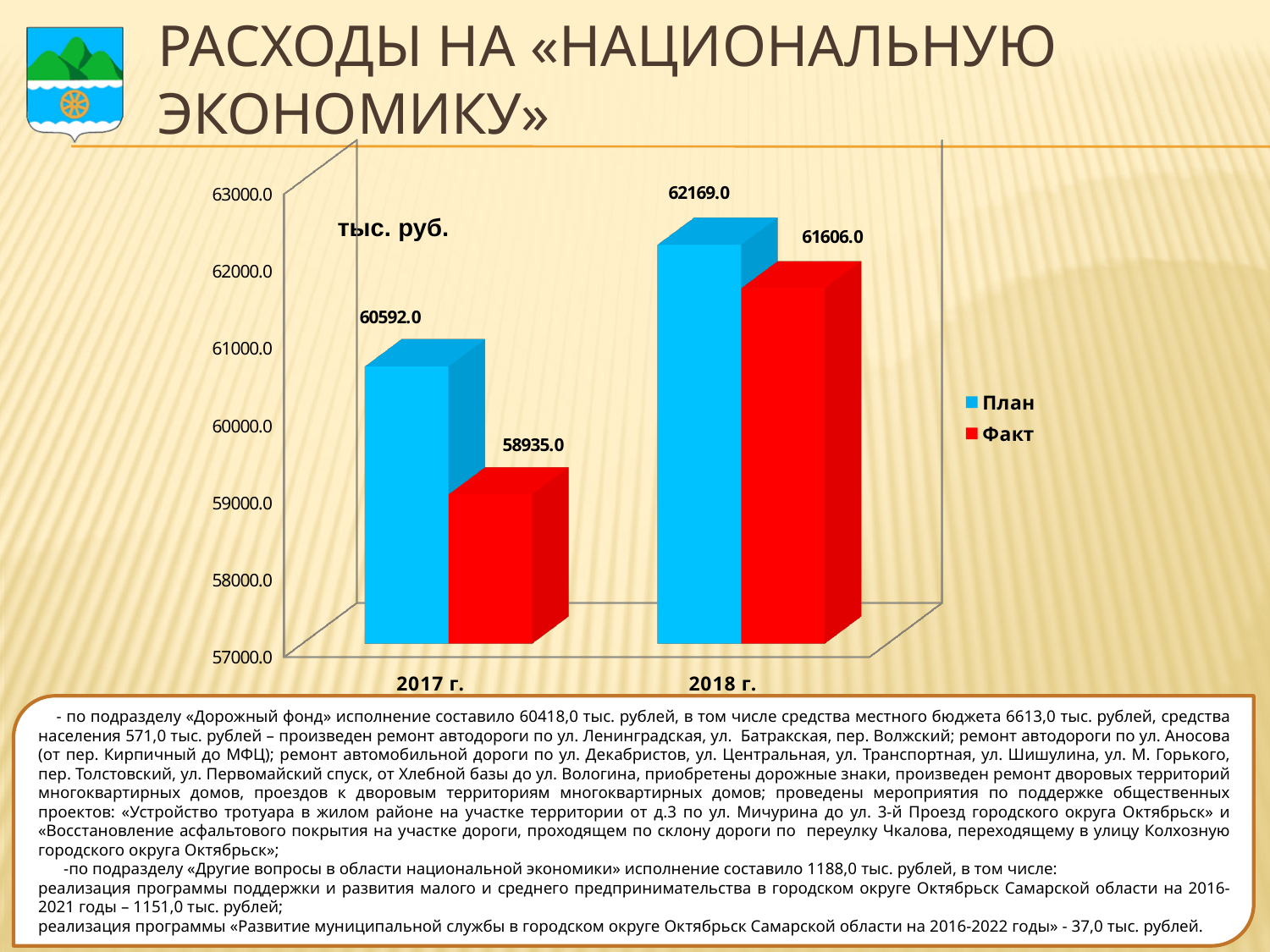
What is the Факт value for 2018 г.? 61606.0 What is the difference between План and Факт for 2017 г.? 1657.0 Which is larger for 2018 г., План or Факт? План What is the План value for 2017 г.? 60592.0 What unit label is shown inside the chart area? тыс. руб. What is the difference between План and Факт for 2018 г.? 563.0 What kind of chart is shown on the slide? Bar chart How many series does the legend list? 2 Which bar on the chart has the lowest value? Факт for 2017 г. What is the Факт value for 2017 г.? 58935.0 What is the План value for 2018 г.? 62169.0 Which year has the higher Факт value? 2018 г.